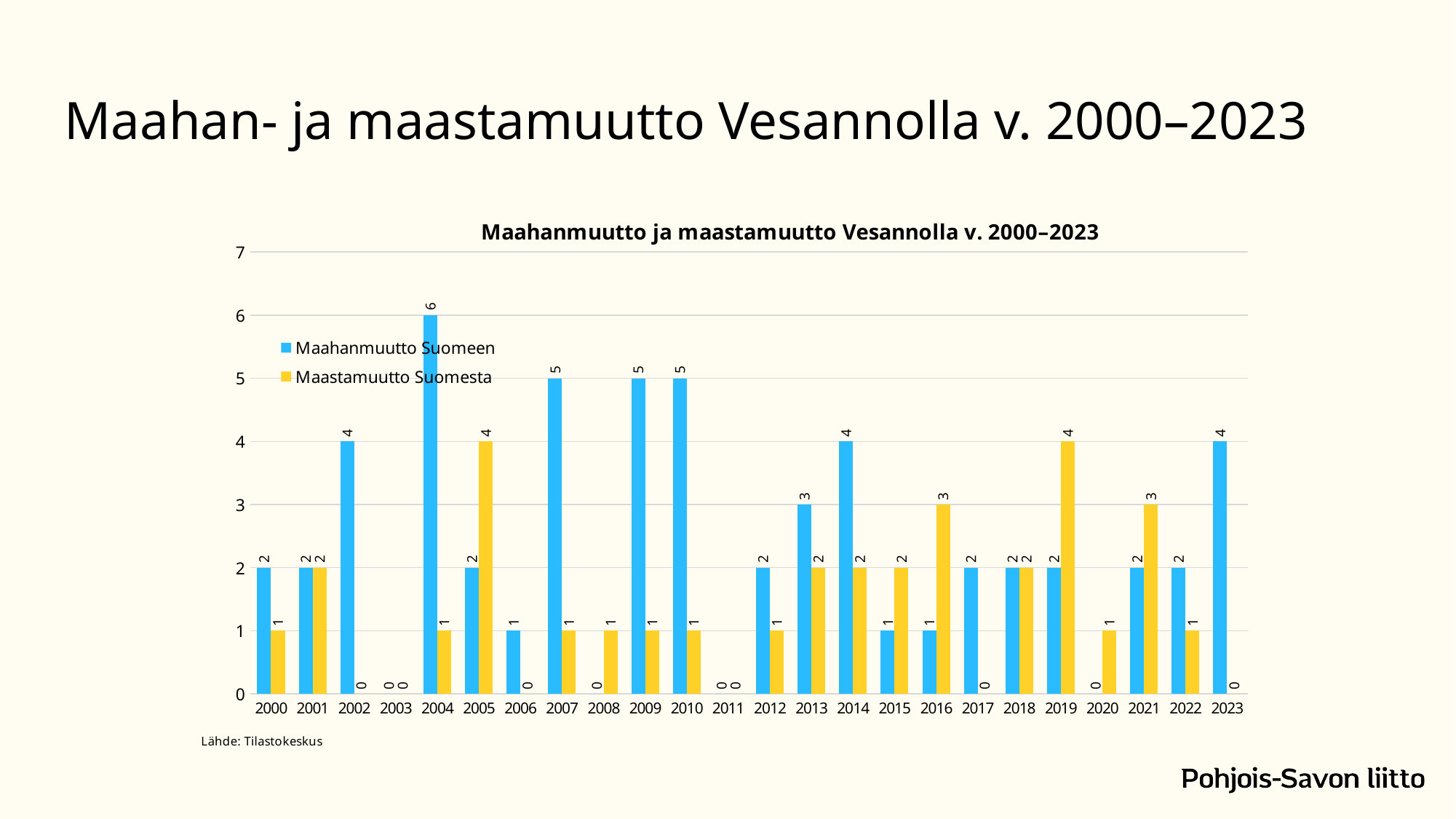
What is the value for Maahanmuutto Suomeen in 2004? 6 What is the difference between Maastamuutto Suomesta and Maahanmuutto Suomeen in 2005? 2 What is the value for Maastamuutto Suomesta in 2019? 4 What is the value for Maastamuutto Suomesta in 2021? 3 What is the value for Maahanmuutto Suomeen in 2013? 3 What kind of chart is shown on the slide? bar chart Which is larger in 2016, Maahanmuutto Suomeen or Maastamuutto Suomesta? Maastamuutto Suomesta What is the title of the chart? Maahanmuutto ja maastamuutto Vesannolla v. 2000–2023 How many years are shown on the x axis of the chart? 24 How many series does the legend list? 2 What is the difference between Maahanmuutto Suomeen in 2004 and in 2007? 1 Which year has the highest value for Maahanmuutto Suomeen? 2004